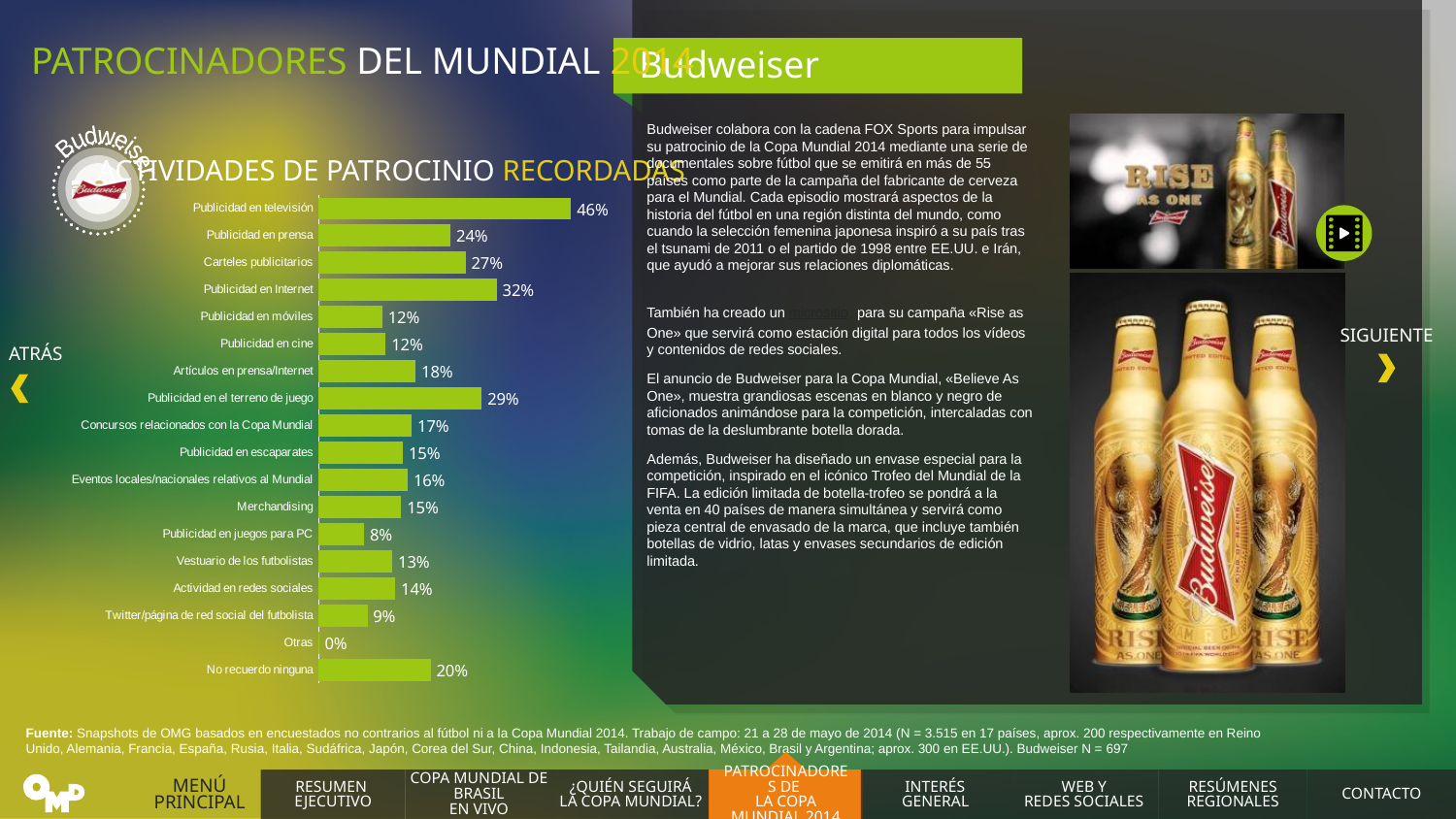
What is the value for "Publicidad en juegos para PC"? 8% What type of chart is shown on the slide? Bar chart What is the difference between "Actividad en redes sociales" and "Twitter/página de red social del futbolista"? 5% Which is larger, "Carteles publicitarios" or "Publicidad en el terreno de juego"? Publicidad en el terreno de juego What is the value for "Publicidad en televisión"? 46% What is the title of the chart? ACTIVIDADES DE PATROCINIO RECORDADAS Which category has the lowest value? Otras Which category has the highest value? Publicidad en televisión What is the value for "No recuerdo ninguna"? 20% What is the value for "Publicidad en Internet"? 32% What is the difference between "Publicidad en televisión" and "Publicidad en prensa"? 22% How many categories are shown in the chart? 18